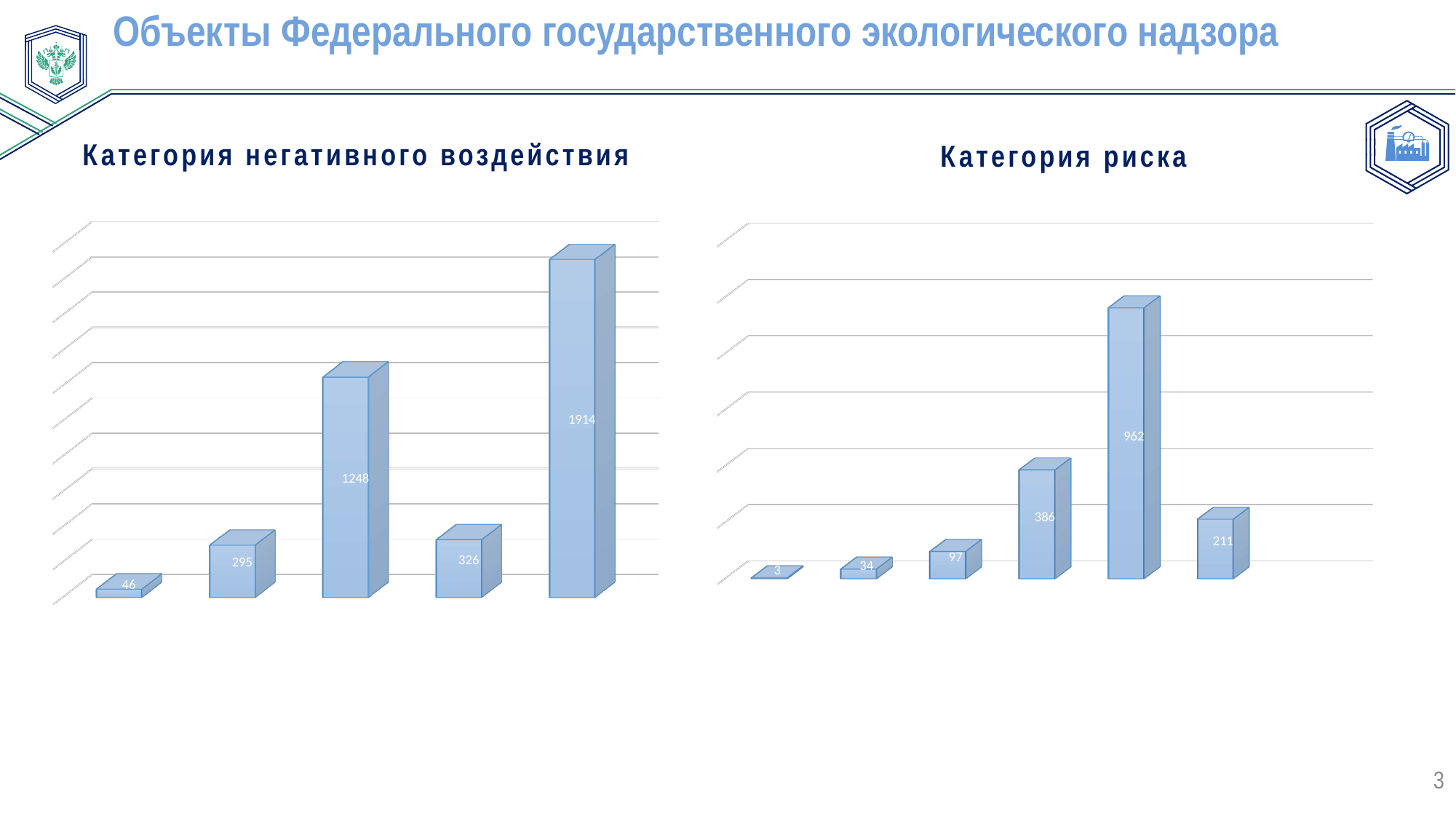
In the right chart titled "Категория риска", what is the value labelled on the rightmost bar? 211 In the left chart titled "Категория негативного воздействия", which is larger: the second bar (295) or the fourth bar (326)? 326 In the left chart titled "Категория негативного воздействия", what is the difference between the tallest bar (1914) and the second tallest bar (1248)? 666 In the right chart titled "Категория риска", how many bars are plotted? 6 In the right chart titled "Категория риска", what is the difference between the bar labelled 962 and the bar labelled 386? 576 What kind of chart is the right chart titled "Категория риска"? Bar chart In the right chart titled "Категория риска", what is the value of the shortest bar? 3 In the left chart titled "Категория негативного воздействия", what is the value of the tallest bar? 1914 In the left chart titled "Категория негативного воздействия", what is the value labelled on the third bar from the left? 1248 In the left chart titled "Категория негативного воздействия", what is the value of the shortest bar? 46 In the right chart titled "Категория риска", what is the value of the tallest bar? 962 In the left chart titled "Категория негативного воздействия", how many bars are plotted? 5